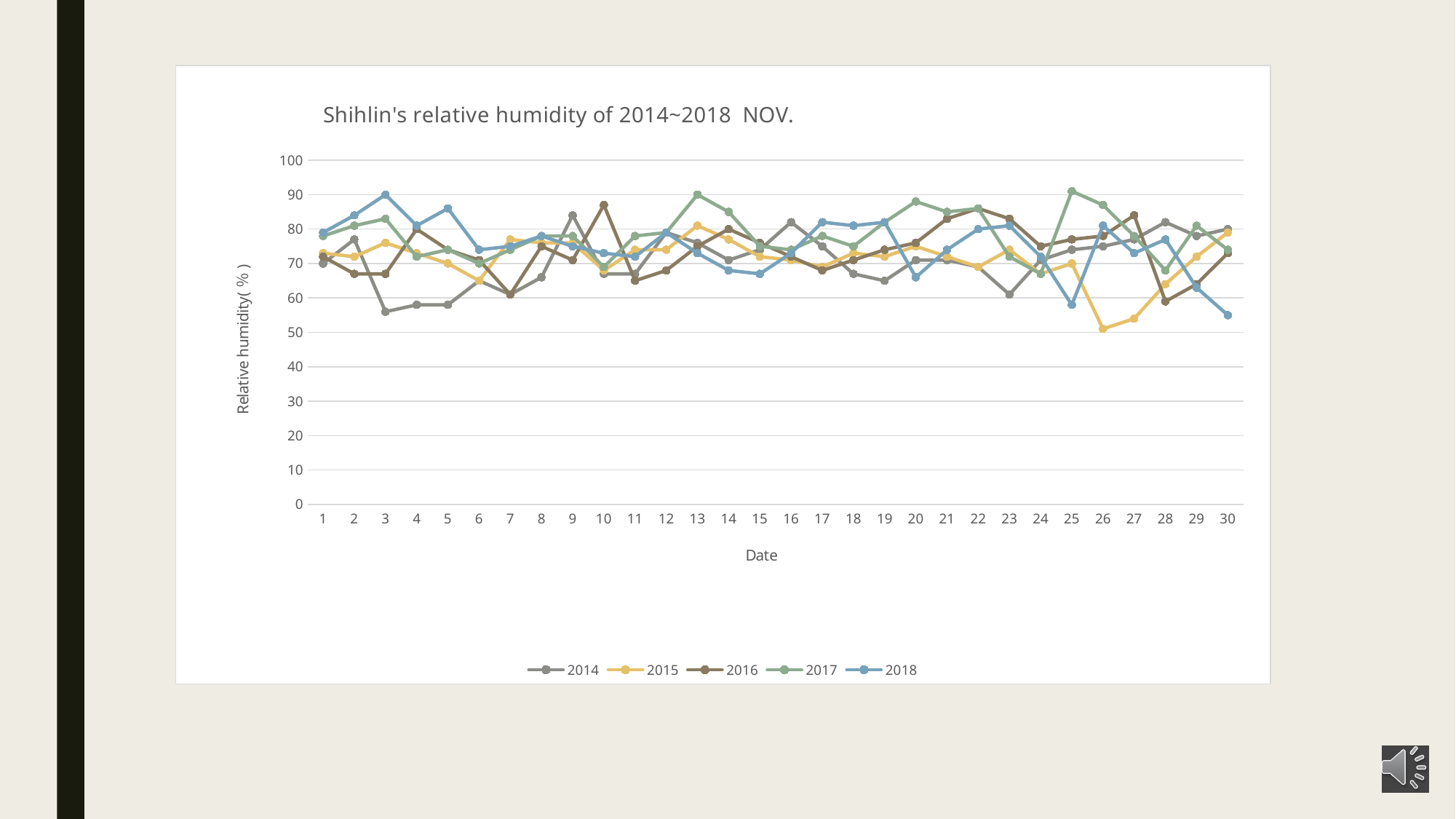
How many dates are plotted along the x axis? 30 On date 3, which is larger, the value for 2018 or the value for 2014? 2018 Is the value for 2018 on date 3 greater or less than 80? greater Is the value for 2015 on date 26 greater or less than 60? less What kind of chart is shown on the slide? line chart How many series does the legend list? 5 What is the label of the vertical axis? Relative humidity( % ) What is the title of the chart? Shihlin's relative humidity of 2014~2018 NOV. Which series has the lowest value on date 26? 2015 Is the value for 2017 on date 25 greater or less than 80? greater Which series has the highest value on date 25? 2017